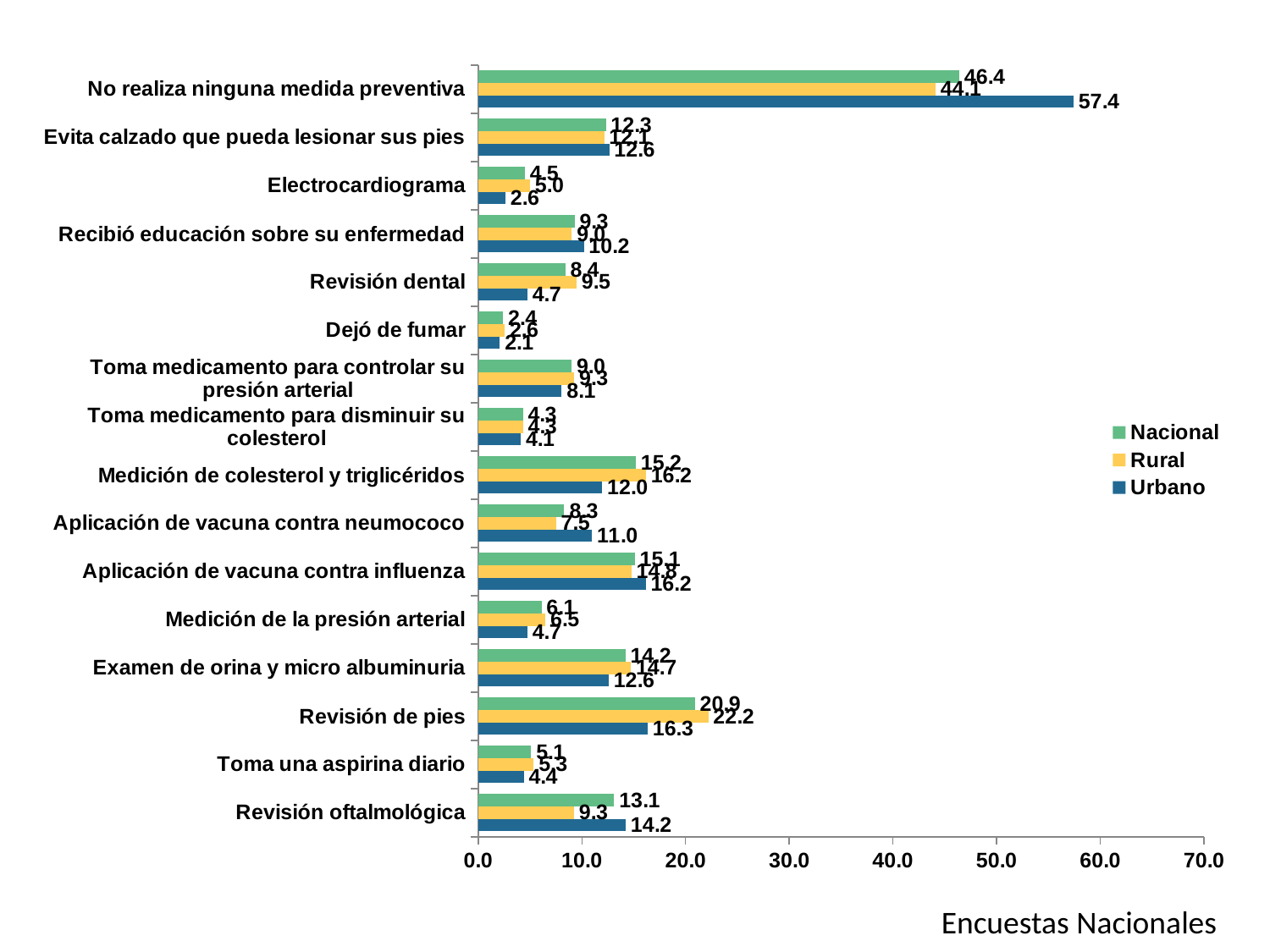
How many series does the legend list? 3 What is the Rural value for 'Revisión de pies'? 22.2 What kind of chart is shown on the slide? bar chart For 'Revisión de pies', which is larger: the Rural value or the Urbano value? Rural How many categories are shown on the chart? 16 Is the Urbano value for 'Electrocardiograma' greater or less than 10.0? less What is the difference between the Urbano and Rural values for 'Revisión oftalmológica'? 4.9 What is the Urbano value for 'No realiza ninguna medida preventiva'? 57.4 Which series is shown in yellow in the legend? Rural Which category has the highest Urbano value? No realiza ninguna medida preventiva What is the Urbano value for 'Revisión oftalmológica'? 14.2 What is the difference between the Urbano and Nacional values for 'No realiza ninguna medida preventiva'? 11.0